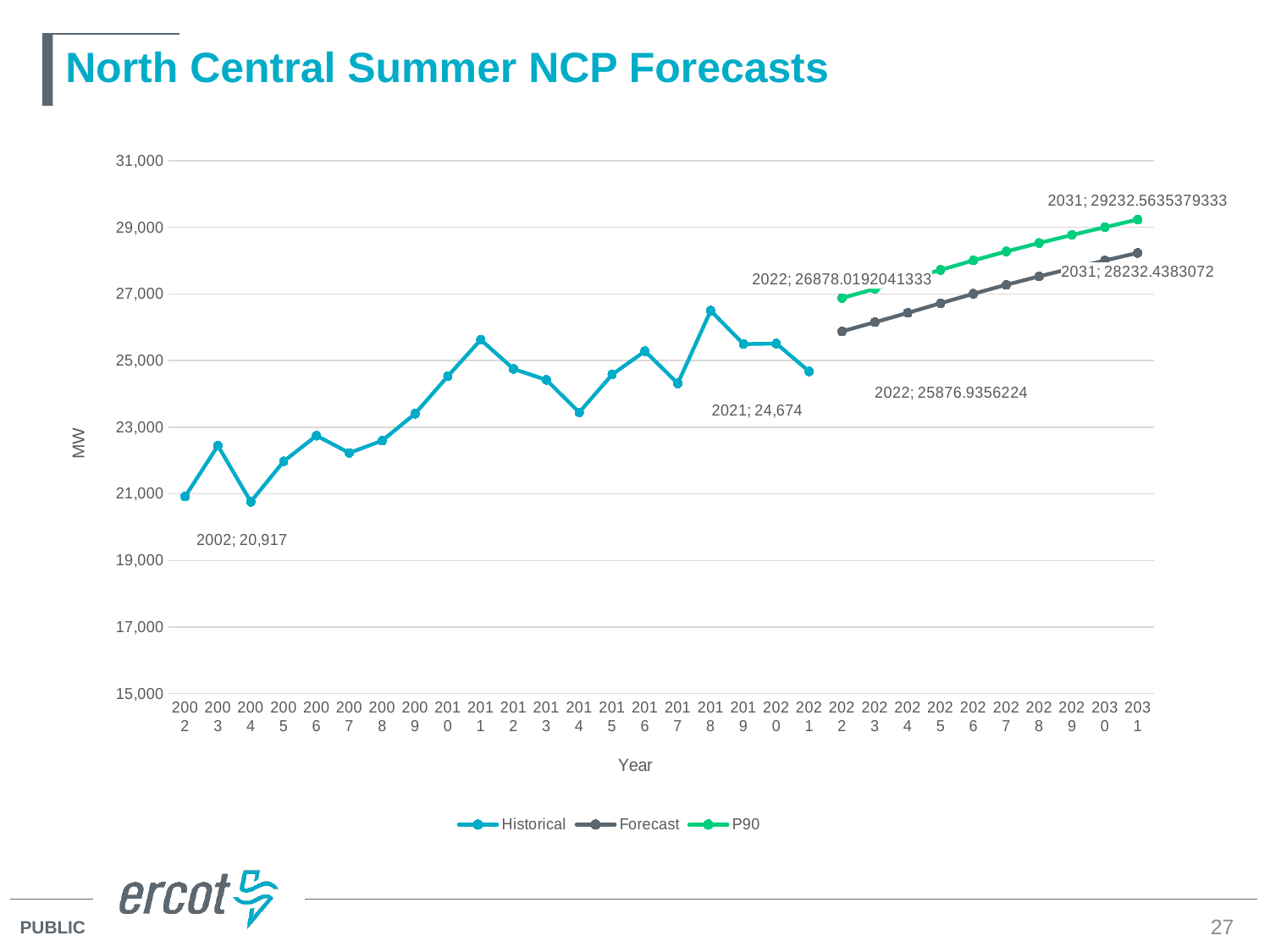
What is the Historical value for 2002? 20,917 Is the Historical value for 2018 greater or less than 25,000? greater Which is larger in 2031, the P90 value or the Forecast value? P90 What is the Forecast value for 2022? 25876.9356224 What is the P90 value for 2022? 26878.0192041333 What kind of chart is shown on the slide? Line chart How many series does the legend list? 3 What is the Historical value for 2021? 24,674 What is the Forecast value for 2031? 28232.4383072 What is the P90 value for 2031? 29232.5635379333 Do the Forecast values rise or fall from 2022 to 2031? Rise What is the label on the y axis? MW